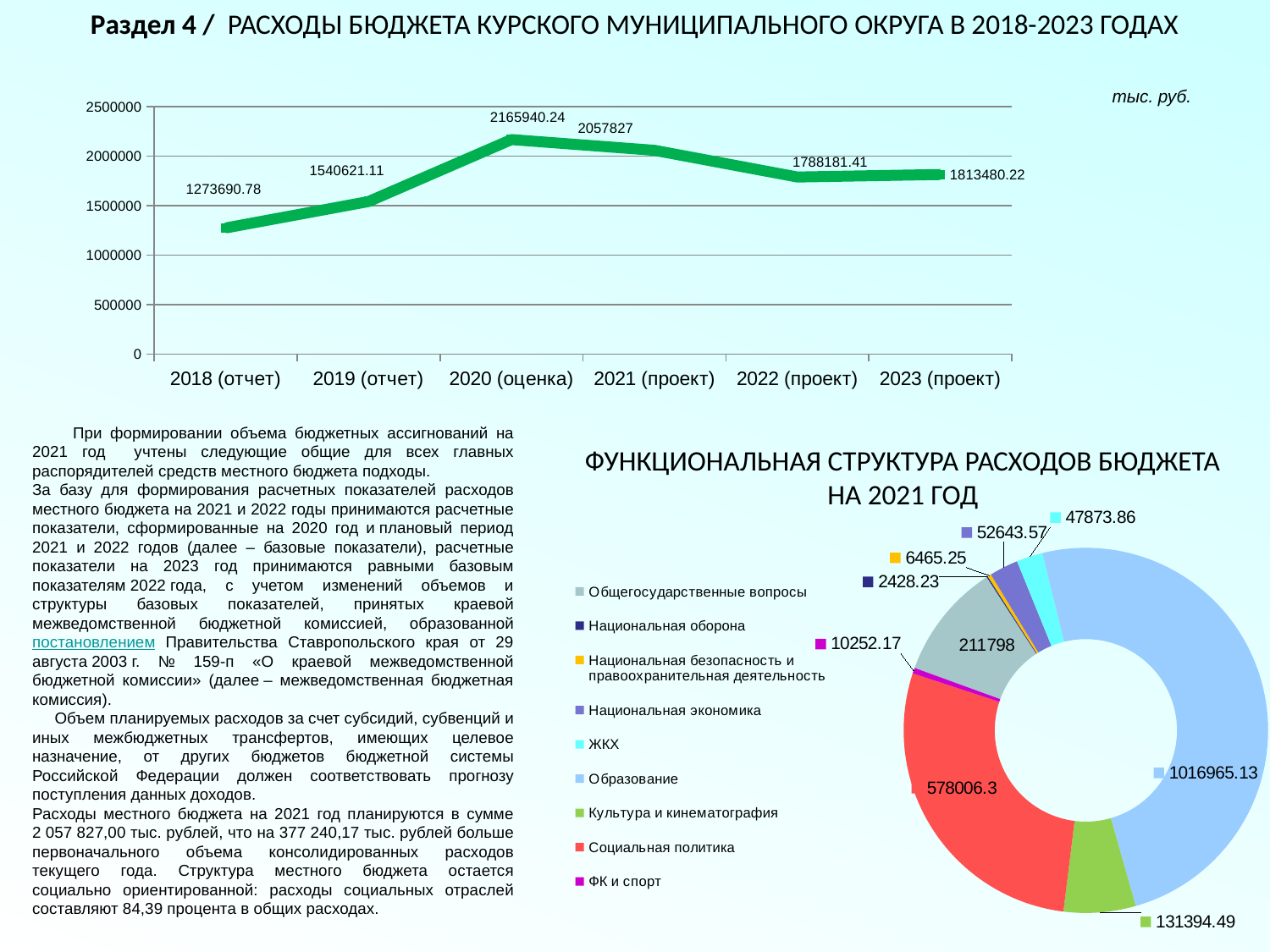
In the doughnut chart 'Функциональная структура расходов бюджета на 2021 год', which category has the smallest value? Национальная оборона In the top line chart, does the value rise or fall from 2018 (отчет) to 2020 (оценка)? rise In the top line chart, which year has the highest value? 2020 (оценка) In the top line chart, what is the value for 2021 (проект)? 2057827 In the doughnut chart 'Функциональная структура расходов бюджета на 2021 год', what is the value for Образование? 1016965.13 In the top line chart, what is the value for 2018 (отчет)? 1273690.78 How many data points are plotted in the top line chart? 6 In the top line chart, what is the difference between the values for 2020 (оценка) and 2021 (проект)? 108113.24 How many categories does the legend of the doughnut chart 'Функциональная структура расходов бюджета на 2021 год' list? 9 What type of chart is the top chart on the slide? line chart In the top line chart, which is larger: the value for 2022 (проект) or 2023 (проект)? 2023 (проект) In the top line chart, which year has the lowest value? 2018 (отчет)